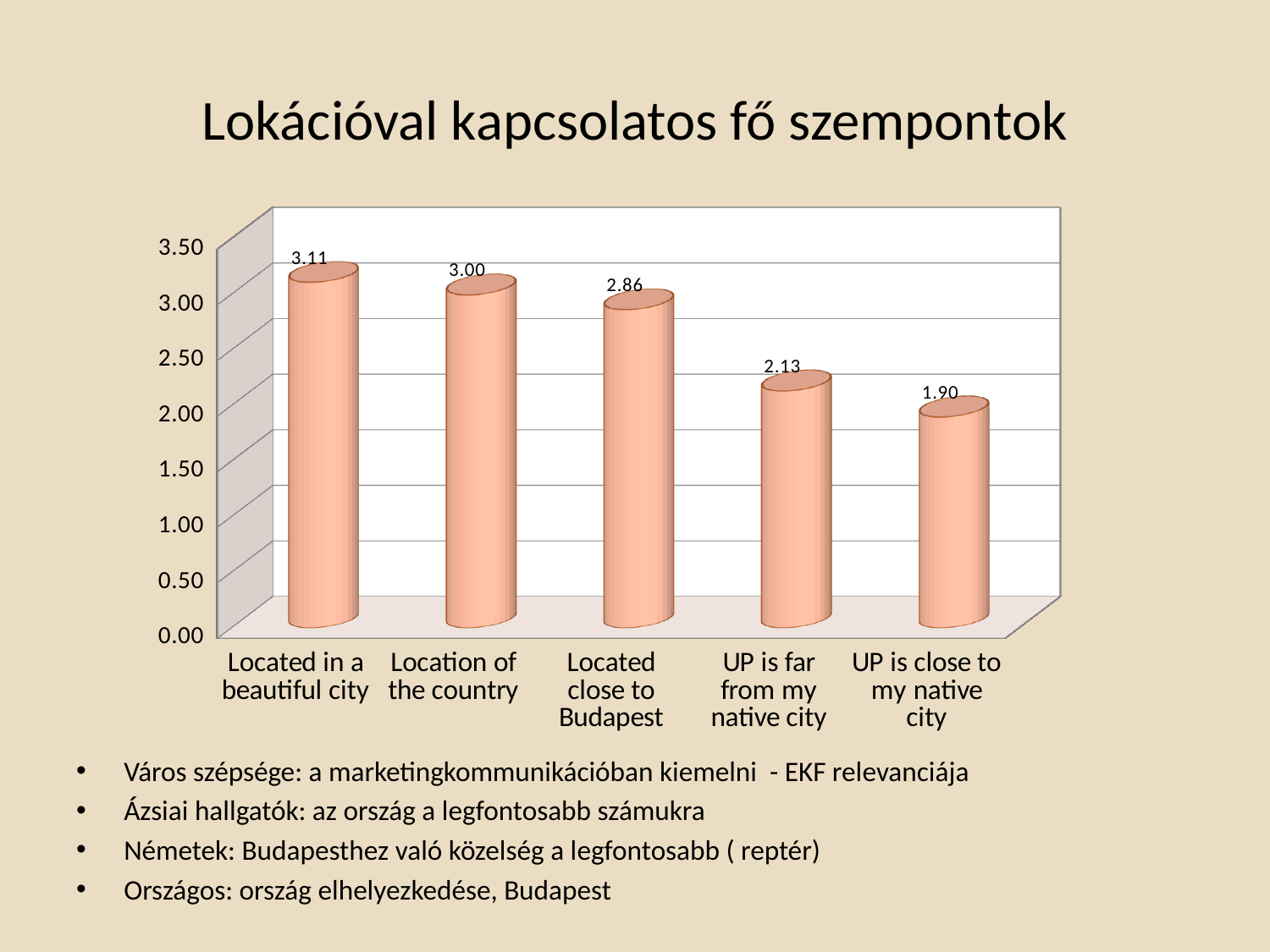
What is the value for "Located close to Budapest"? 2.86 What is the value for "UP is far from my native city"? 2.13 Which category has the lowest value? UP is close to my native city Which category has the highest value? Located in a beautiful city How many categories are shown on the chart? 5 What is the value for "UP is close to my native city"? 1.90 What kind of chart is shown on the slide? Bar chart What is the difference between the values for "Located in a beautiful city" and "UP is close to my native city"? 1.21 What is the value for "Location of the country"? 3.00 Which is larger, the value for "Located close to Budapest" or the value for "UP is far from my native city"? Located close to Budapest Do the values rise or fall from left to right along the x axis? Fall What is the value for "Located in a beautiful city"? 3.11